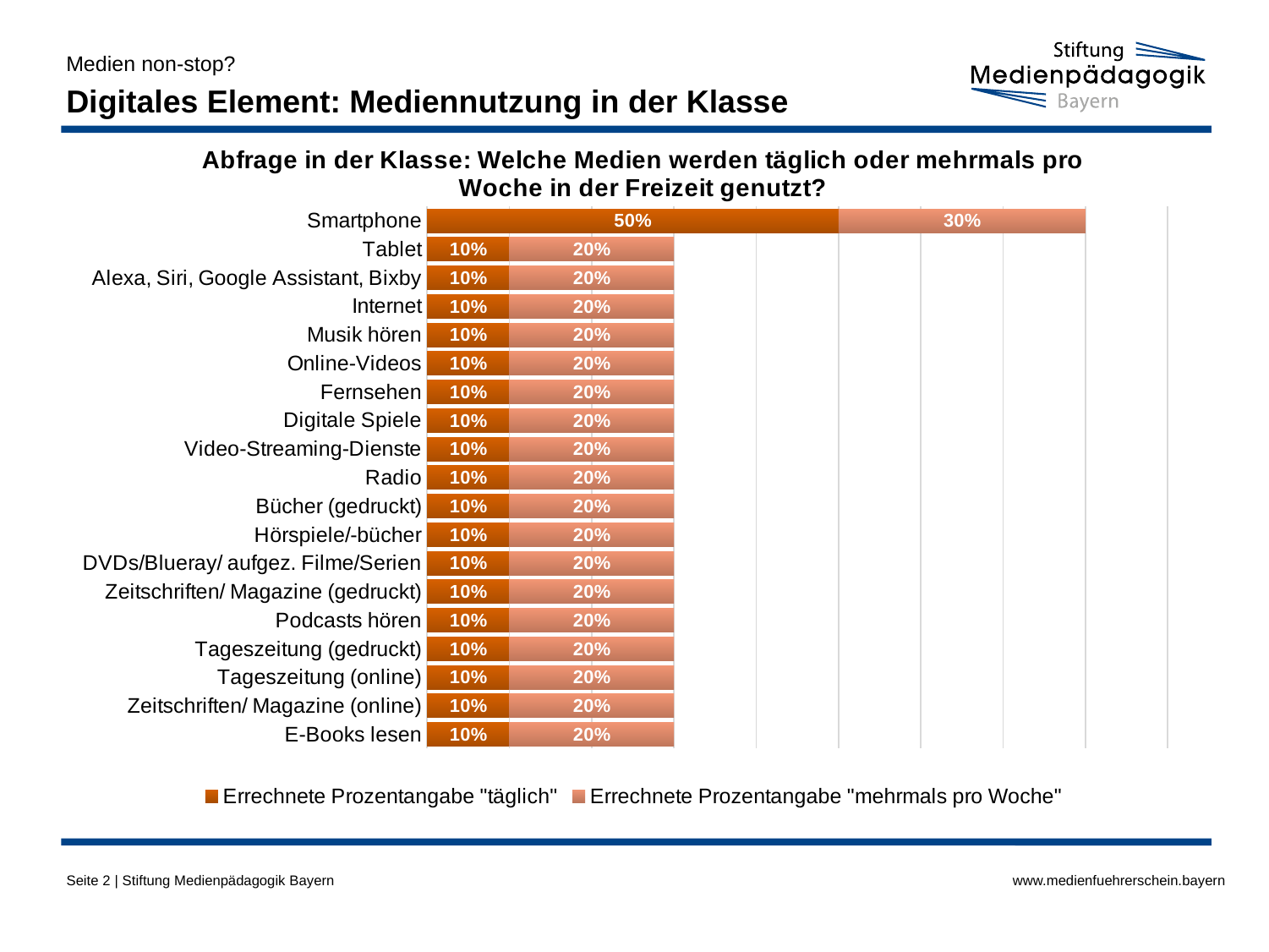
What is the value of "Errechnete Prozentangabe "mehrmals pro Woche"" for Smartphone? 30% What is the difference between the "täglich" value for Smartphone and the "täglich" value for Tablet? 40% What is the total of the stacked bar for Smartphone? 80% Which category has the highest value for "Errechnete Prozentangabe "täglich""? Smartphone What is the value of "Errechnete Prozentangabe "täglich"" for Fernsehen? 10% What is the value of "Errechnete Prozentangabe "täglich"" for Smartphone? 50% What is the value of "Errechnete Prozentangabe "mehrmals pro Woche"" for E-Books lesen? 20% How many series does the legend list? 2 What kind of chart is shown on the slide? Stacked bar chart How many categories are shown in the chart? 19 What is the total of the stacked bar for Radio? 30% Which is larger: the "mehrmals pro Woche" value for Smartphone or the "mehrmals pro Woche" value for Internet? Smartphone